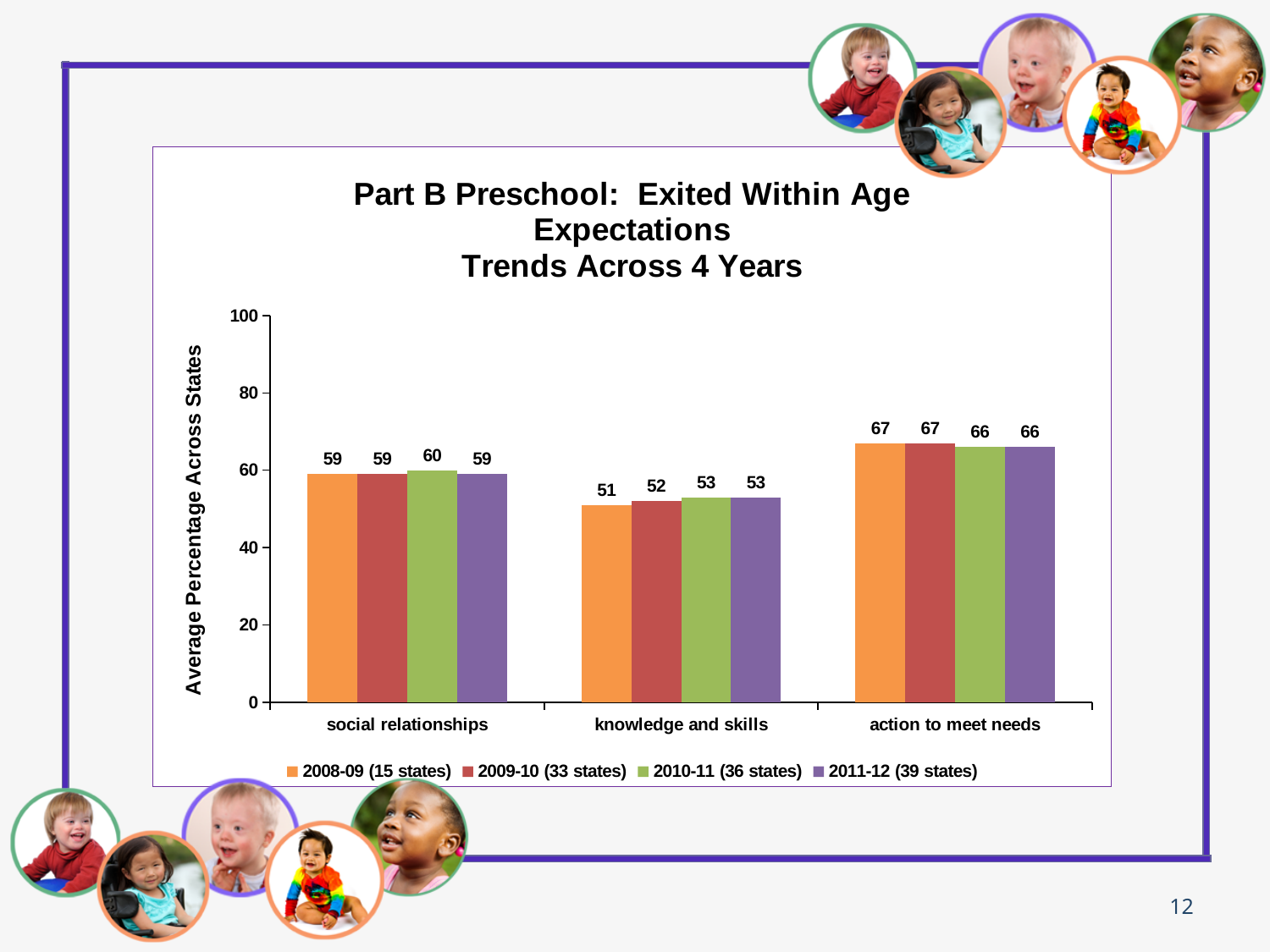
How many outcome categories are shown on the x axis? 3 What is the value for action to meet needs in 2011-12 (39 states)? 66 What is the difference between the 2008-09 (15 states) values for action to meet needs and knowledge and skills? 16 Which outcome category has the lowest value in 2011-12 (39 states)? knowledge and skills Which outcome category has the highest value in 2009-10 (33 states)? action to meet needs Which is larger for knowledge and skills: the 2008-09 (15 states) value or the 2010-11 (36 states) value? 2010-11 (36 states) What is the value for knowledge and skills in 2008-09 (15 states)? 51 What is the value for social relationships in 2010-11 (36 states)? 60 How many series does the legend list? 4 What kind of chart is shown on the slide? bar chart What is the label of the vertical axis? Average Percentage Across States Is the value for social relationships in 2008-09 (15 states) greater or less than 40? greater